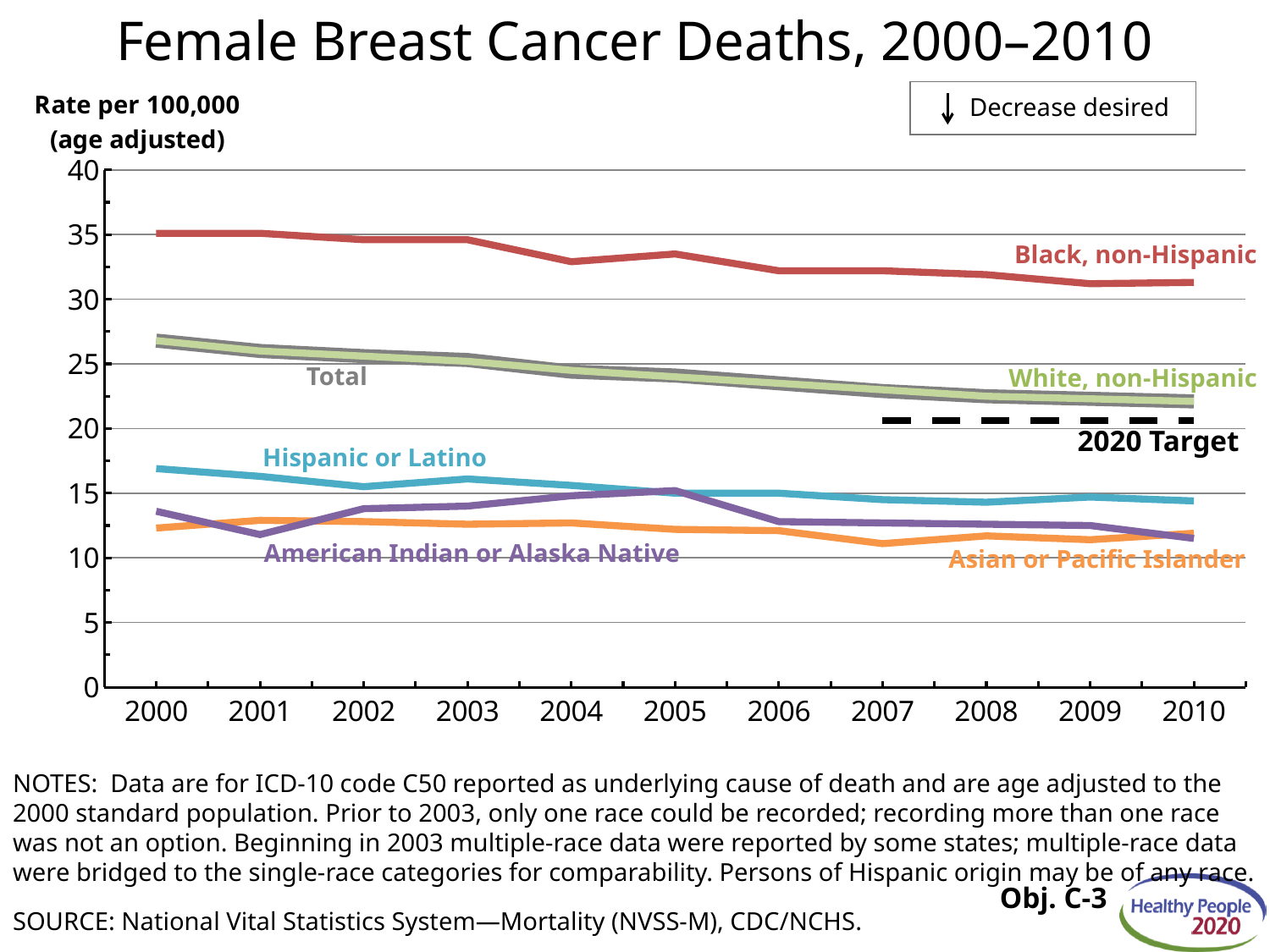
Is the 2010 value for Asian or Pacific Islander greater or less than 15? less Is the 2000 value for Hispanic or Latino greater or less than 15? greater Is the 2010 value for White, non-Hispanic greater or less than 20? greater Does the Black, non-Hispanic rate rise or fall from 2000 to 2010? fall Which group has the lowest female breast cancer death rate in 2000? Asian or Pacific Islander In 2000, which is larger: the rate for Hispanic or Latino or the rate for Asian or Pacific Islander? Hispanic or Latino How many years are plotted along the x axis? 11 Which group has the highest female breast cancer death rate in 2010? Black, non-Hispanic What kind of chart is shown on the slide? line chart What is the title of the chart? Female Breast Cancer Deaths, 2000–2010